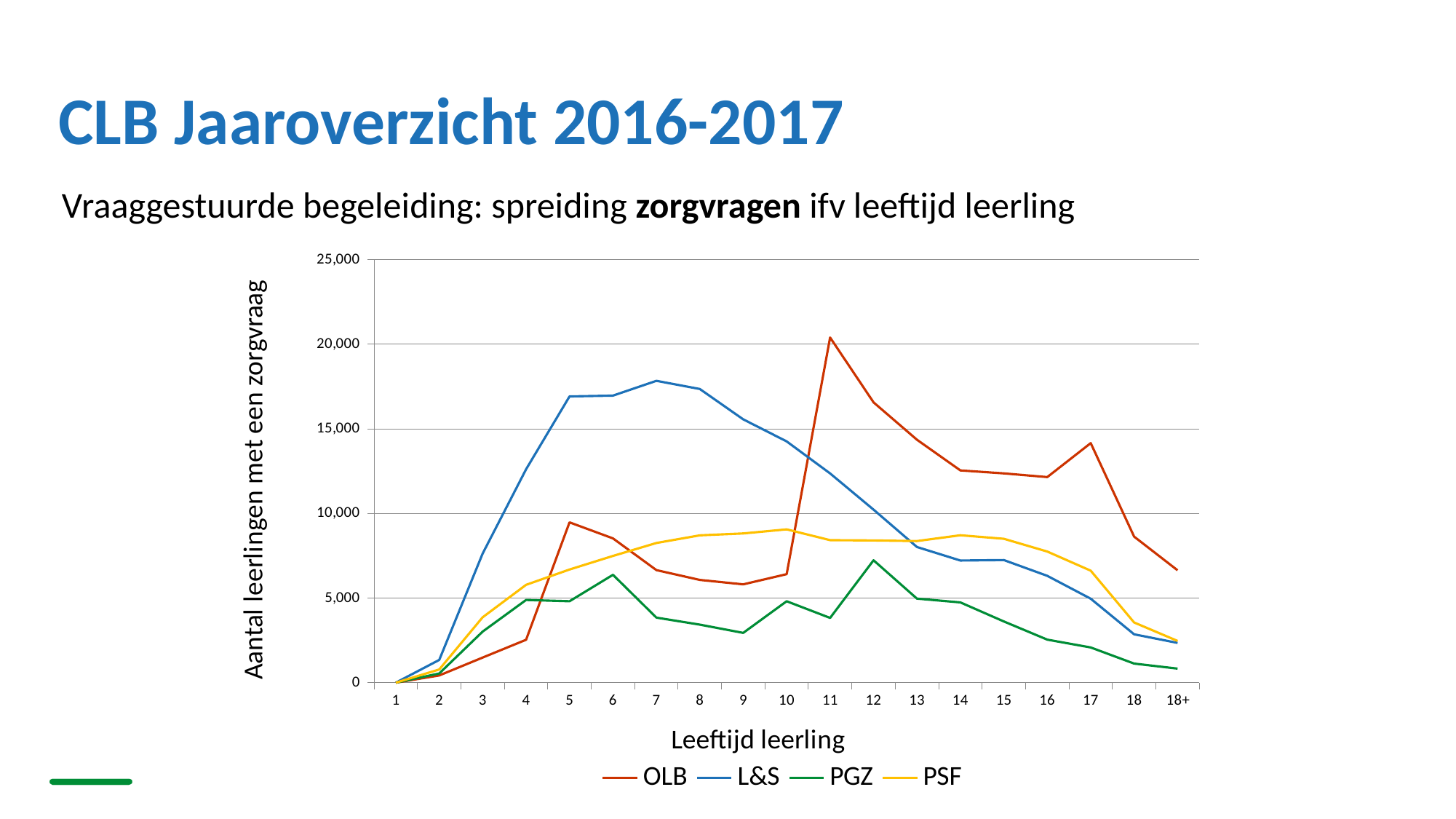
What kind of chart is shown on the slide? Line chart Is the value for OLB at age 11 greater or less than 20,000? greater How many series does the legend list? 4 How many age categories are shown along the x axis? 19 Does the L&S series rise or fall between age 7 and age 18+? Fall At age 5, which series has the larger value, L&S or OLB? L&S Is the value for L&S at age 7 greater or less than 15,000? greater At which age does the L&S series reach its peak? 7 At which age does the OLB series reach its peak? 11 What is the label of the y axis? Aantal leerlingen met een zorgvraag Is the value for PGZ at age 12 greater or less than 10,000? less Which series reaches the highest value anywhere on the chart? OLB